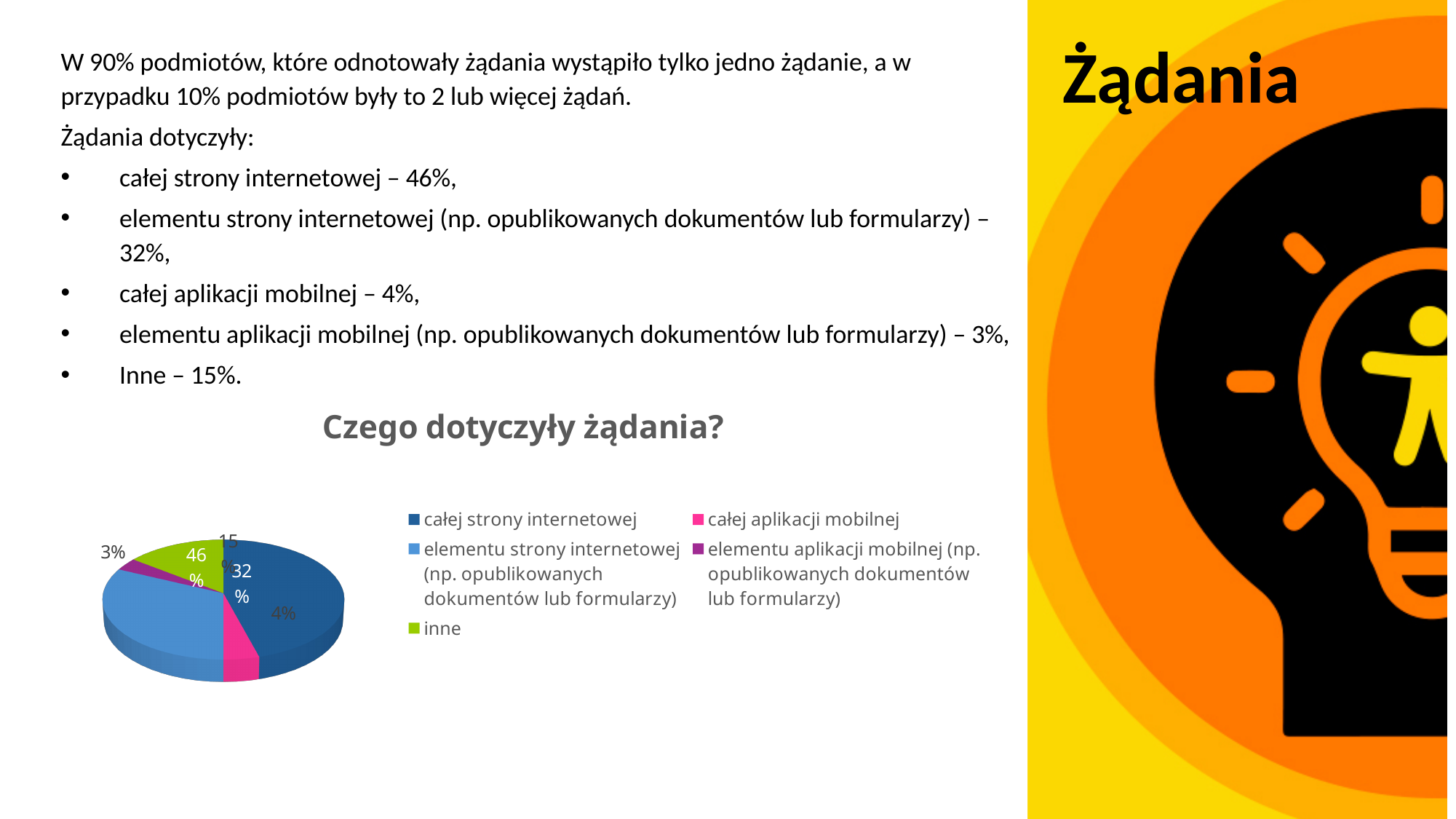
Which category has the largest share of the pie? całej strony internetowej Which category has the smallest share of the pie? elementu aplikacji mobilnej What is the difference in percentage points between 'całej strony internetowej' and 'elementu strony internetowej'? 14 What share of the pie is 'całej aplikacji mobilnej'? 4% How many entries does the chart legend list? 5 What share of the pie is 'elementu strony internetowej'? 32% What share of the pie is 'inne'? 15% What kind of chart is shown on the slide? pie chart Which colour represents 'inne' in the pie chart? green What is the title of the chart? Czego dotyczyły żądania? How many slices does the pie chart have? 5